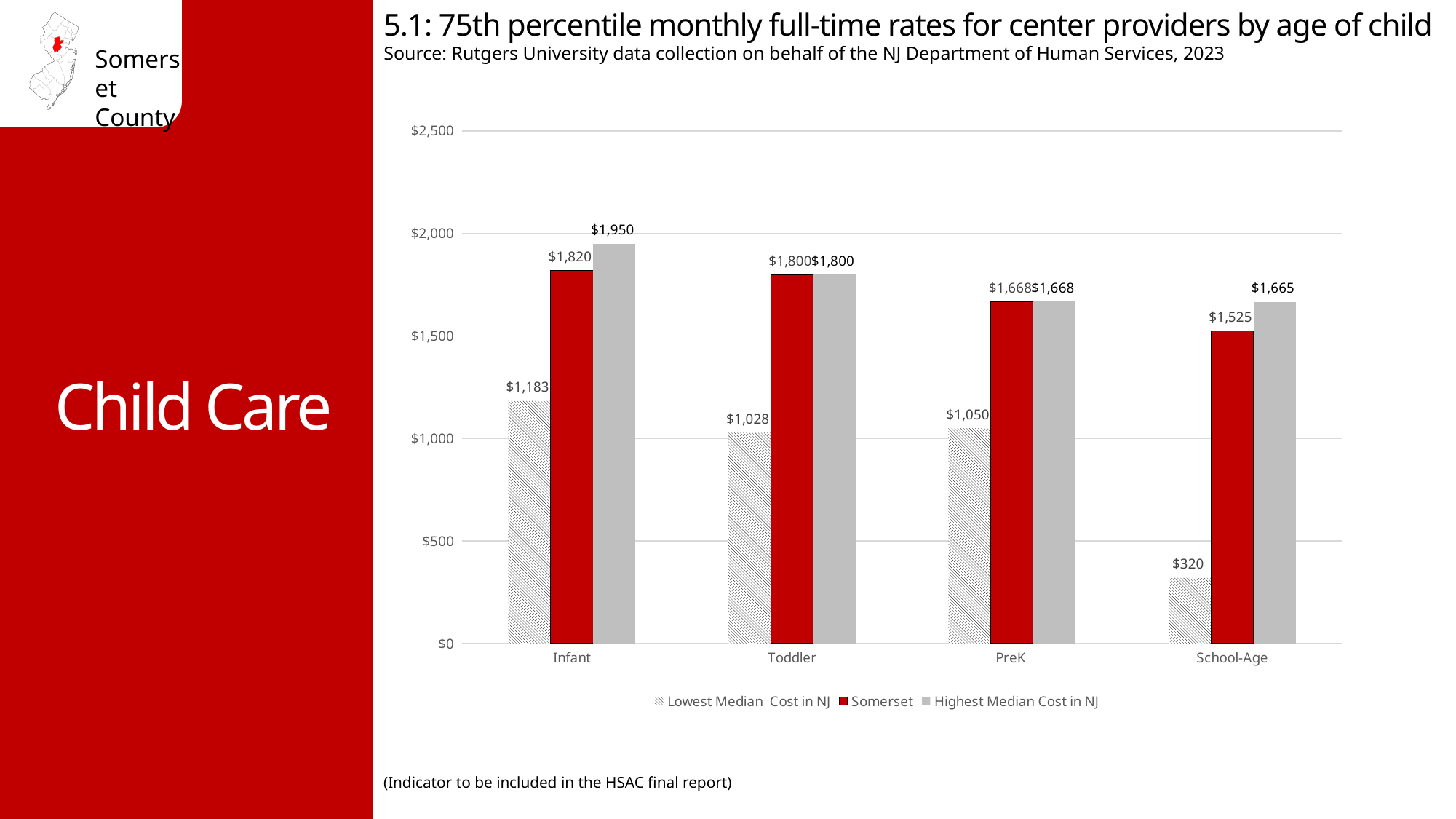
Which age group has the highest Somerset value? Infant How many series does the legend list? 3 Do the Somerset values rise or fall from Infant to School-Age? Fall Which is larger for Toddler: the Lowest Median Cost in NJ or the Somerset value? Somerset How many age groups are shown on the x axis? 4 Which age group has the lowest Lowest Median Cost in NJ value? School-Age What is the Somerset value for Infant? $1,820 What is the difference between the Highest Median Cost in NJ and the Somerset value for School-Age? $140 What is the Highest Median Cost in NJ value for Infant? $1,950 What kind of chart is shown on the slide? Bar chart What is the Lowest Median Cost in NJ value for School-Age? $320 What is the Somerset value for PreK? $1,668